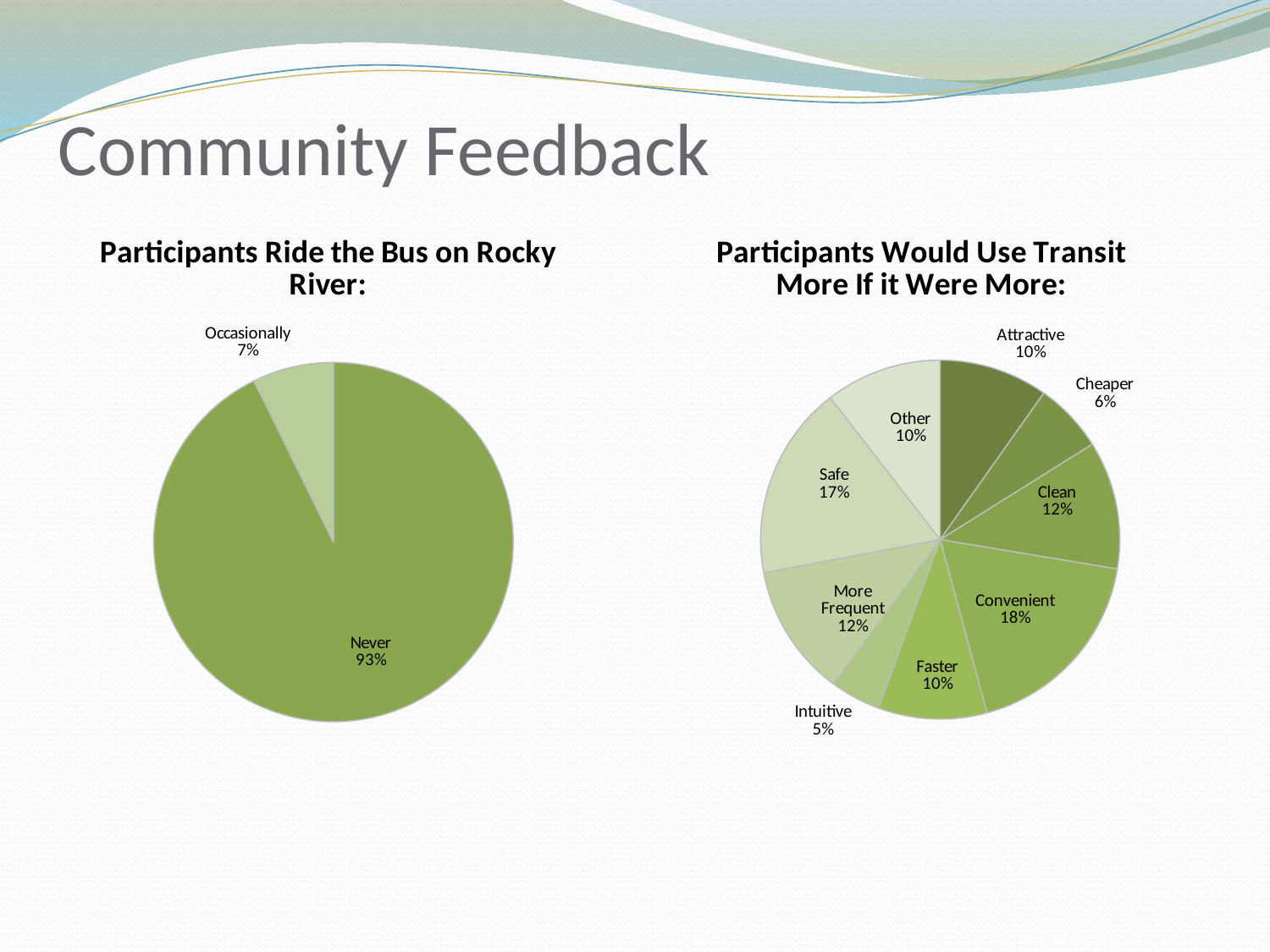
What kind of chart is the 'Participants Ride the Bus on Rocky River' chart? Pie chart In the 'Participants Would Use Transit More If it Were More' chart, what share is Safe? 17% In the 'Participants Would Use Transit More If it Were More' chart, which is larger, Clean or Cheaper? Clean In the 'Participants Ride the Bus on Rocky River' chart, what share of participants answered Occasionally? 7% In the 'Participants Ride the Bus on Rocky River' chart, what share of participants answered Never? 93% In the 'Participants Ride the Bus on Rocky River' chart, what is the difference between the Never and Occasionally shares? 86% In the 'Participants Would Use Transit More If it Were More' chart, how many categories are shown? 9 In the 'Participants Would Use Transit More If it Were More' chart, what is the difference between the Convenient and Cheaper shares? 12% In the 'Participants Would Use Transit More If it Were More' chart, which category has the largest share? Convenient In the 'Participants Would Use Transit More If it Were More' chart, which category has the smallest share? Intuitive How many slices does the 'Participants Ride the Bus on Rocky River' chart have? 2